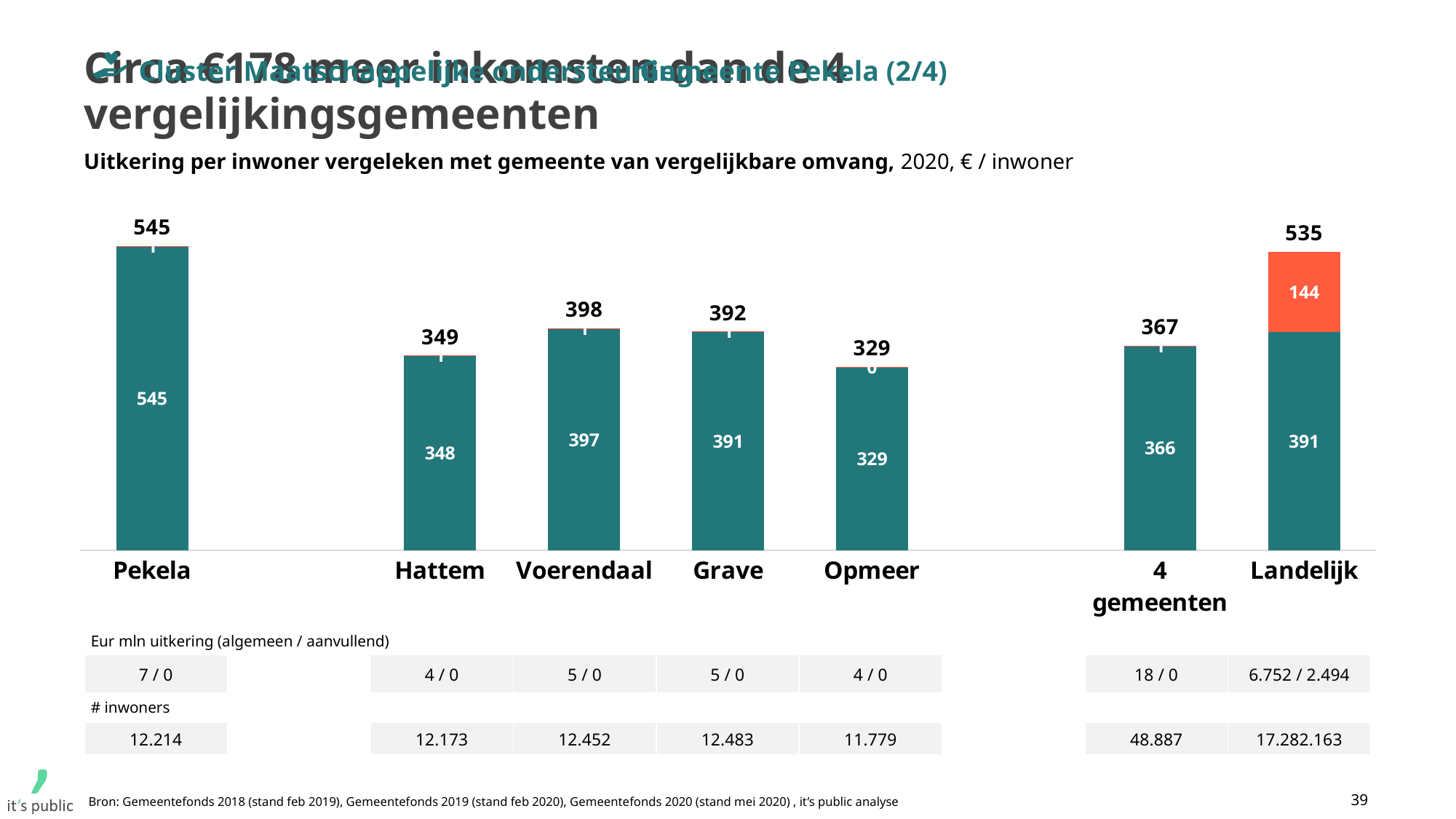
What is the total value shown above the bar for 4 gemeenten? 367 What is the total value shown above the bar for Hattem? 349 Which has a larger total value, Voerendaal or Grave? Voerendaal What is the total value shown above the bar for Pekela? 545 What is the value of the orange (top) segment of the Landelijk bar? 144 What is the value of the teal (bottom) segment of the Opmeer bar? 329 Which category has the lowest total value? Opmeer What is the difference between the total for Pekela and the total for 4 gemeenten? 178 How many categories are shown on the x axis of the chart? 7 Which category has the highest total value? Pekela What kind of chart is shown on the slide? Stacked bar chart What is the value of the teal (bottom) segment of the Landelijk bar? 391